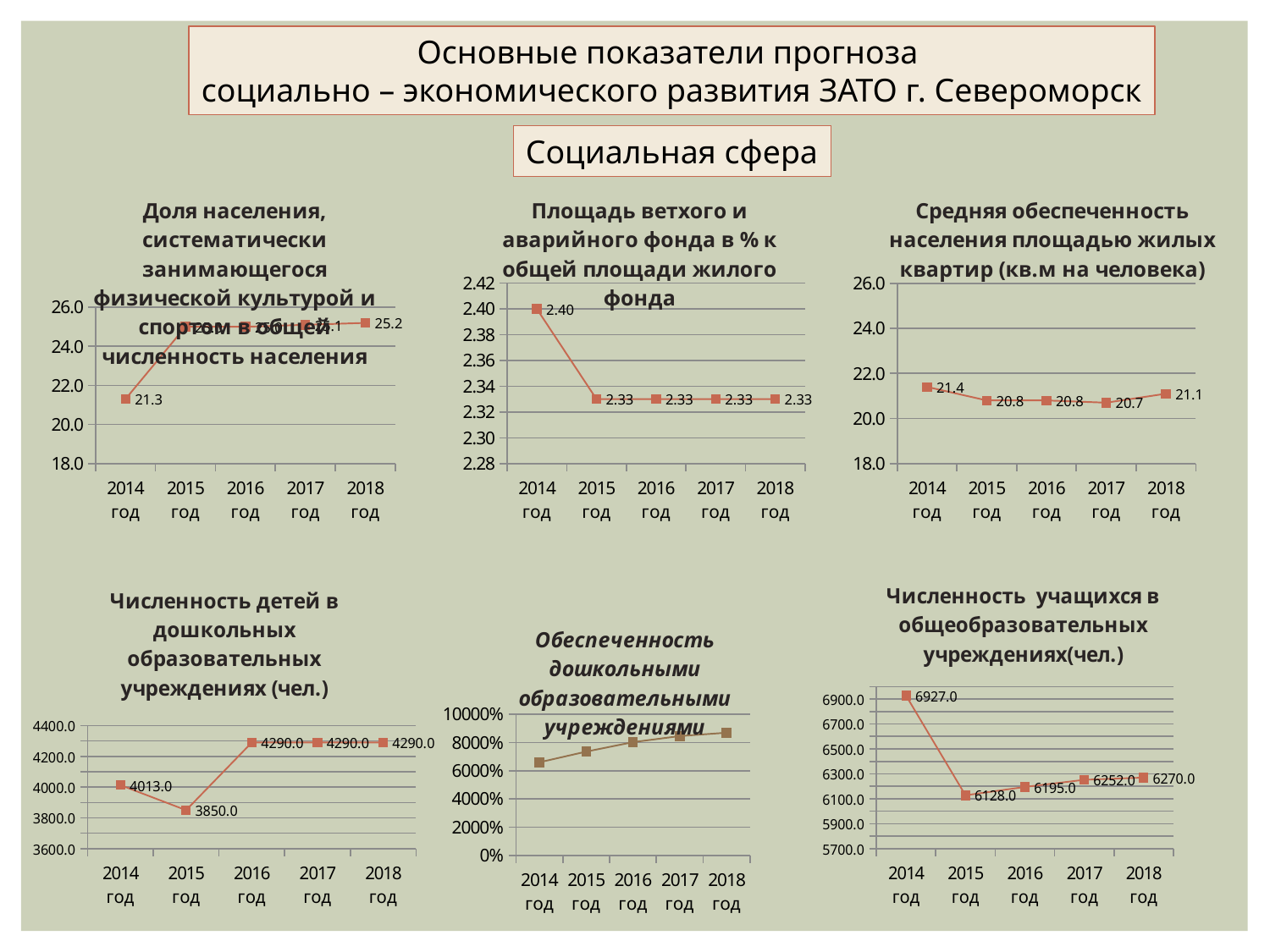
In the chart 'Площадь ветхого и аварийного фонда в % к общей площади жилого фонда', what is the value for 2018 год? 2.33 In the chart 'Численность детей в дошкольных образовательных учреждениях (чел.)', what is the difference between the 2016 год and 2014 год values? 277.0 What type of chart is 'Доля населения, систематически занимающегося физической культурой и спортом в общей численность населения'? line chart In the chart 'Численность учащихся в общеобразовательных учреждениях(чел.)', is the value for 2015 год larger or smaller than the value for 2018 год? smaller In the chart 'Численность учащихся в общеобразовательных учреждениях(чел.)', which year has the highest value? 2014 год In the chart 'Численность детей в дошкольных образовательных учреждениях (чел.)', what is the value for 2015 год? 3850.0 In the chart 'Средняя обеспеченность населения площадью жилых квартир (кв.м на человека)', what is the difference between the 2014 год and 2018 год values? 0.3 In the chart 'Обеспеченность дошкольными образовательными учреждениями', is the value for 2018 год greater or less than 8000%? greater In the chart 'Обеспеченность дошкольными образовательными учреждениями', do the values rise or fall from 2014 год to 2018 год? rise In the chart 'Площадь ветхого и аварийного фонда в % к общей площади жилого фонда', what is the value for 2014 год? 2.40 In the chart 'Средняя обеспеченность населения площадью жилых квартир (кв.м на человека)', which year has the lowest value? 2017 год In the chart 'Численность учащихся в общеобразовательных учреждениях(чел.)', what is the value for 2017 год? 6252.0